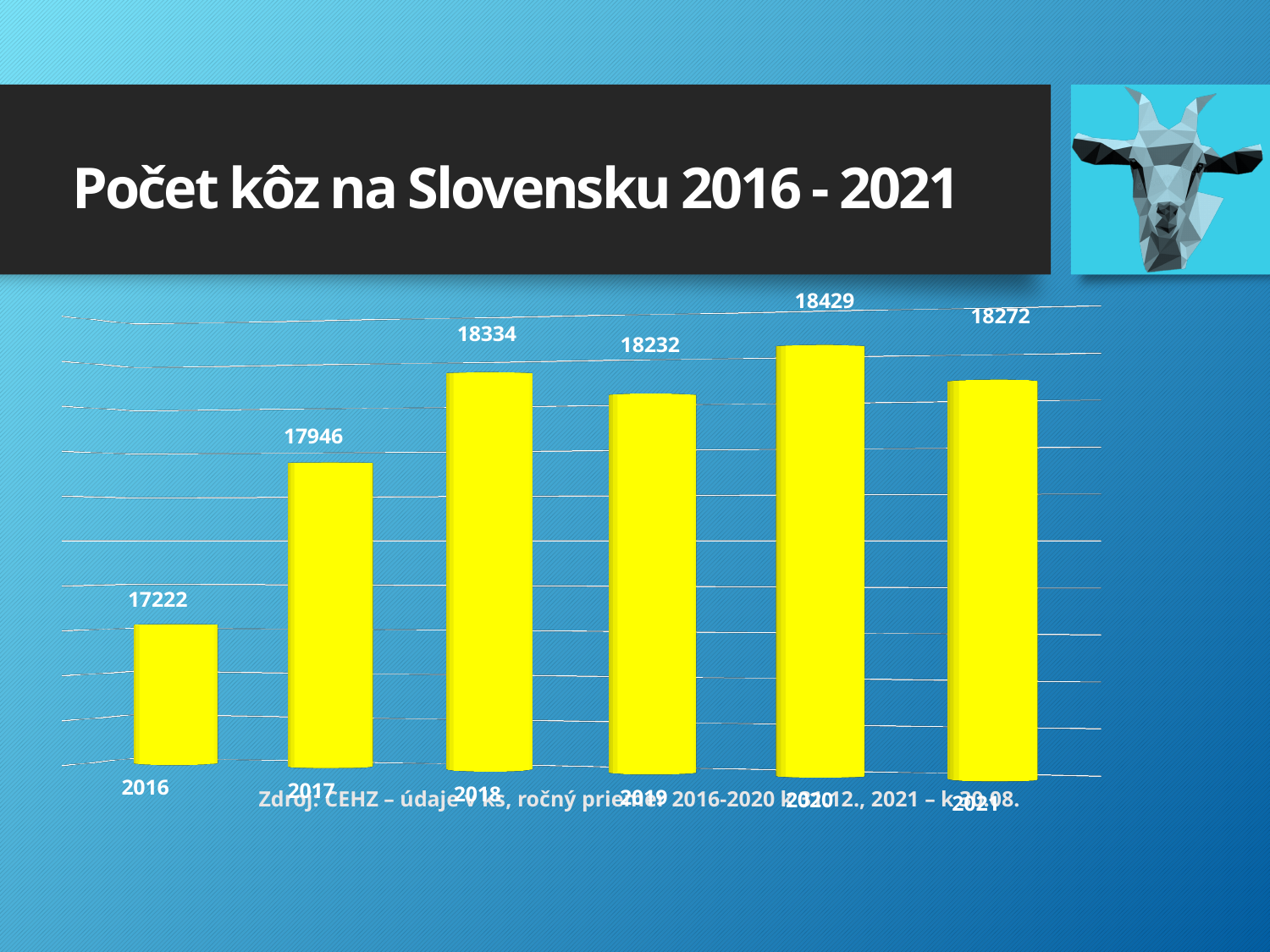
What is the title of the chart? Počet kôz na Slovensku 2016 - 2021 What kind of chart is shown on the slide? bar chart How many years are shown on the chart? 6 Which year has the lowest value? 2016 What is the difference between the values for 2018 and 2017? 388 Which is larger, the value for 2018 or the value for 2019? 2018 What is the value for 2019? 18232 What is the value for 2016? 17222 What is the difference between the values for 2020 and 2016? 1207 Which year has the highest value? 2020 What is the value for 2021? 18272 Does the value rise or fall from 2016 to 2017? rise